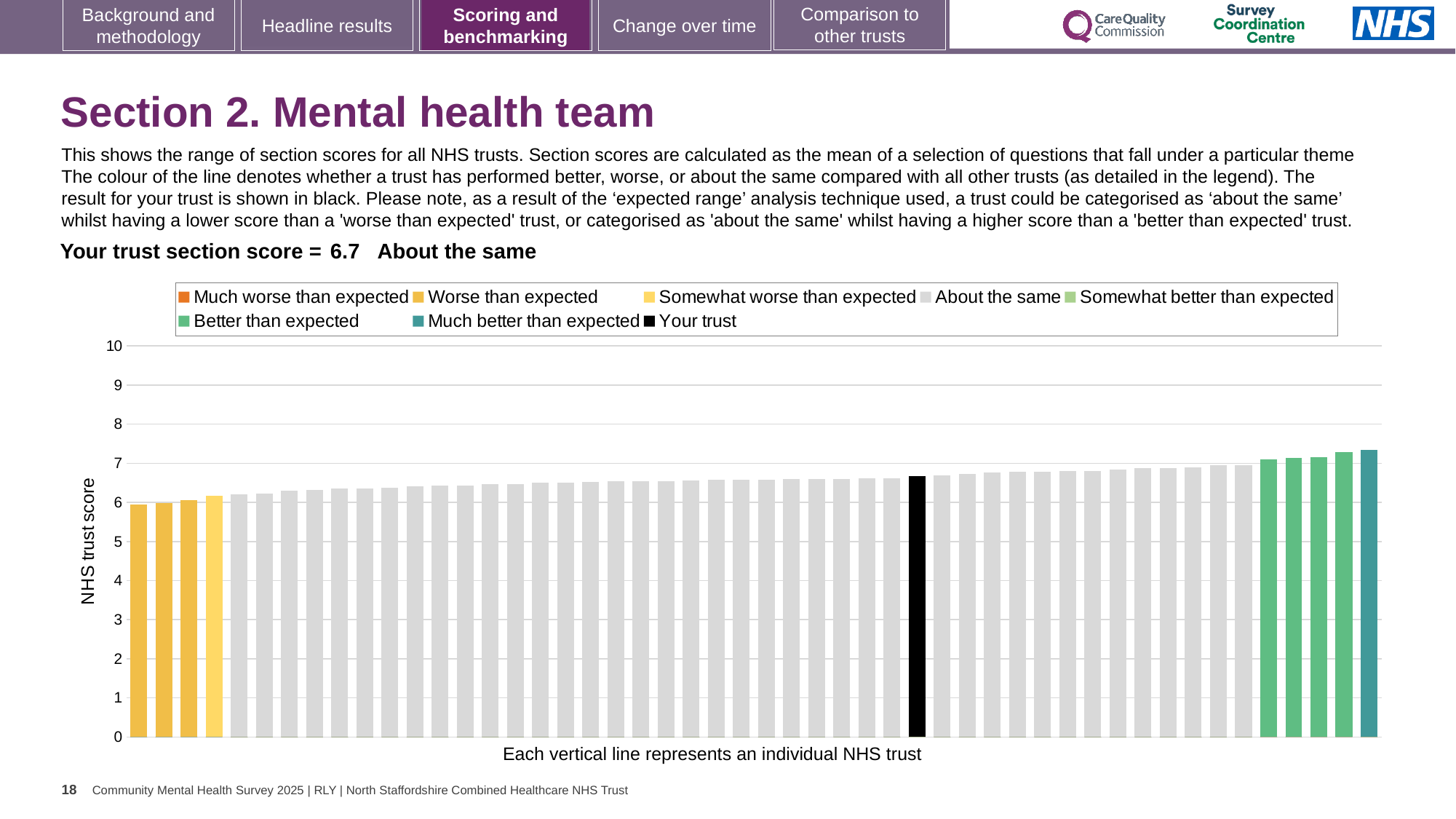
What does each vertical line in the chart represent, according to the x-axis label? an individual NHS trust What kind of chart is shown on the slide? bar chart How many entries does the chart legend list? 8 Is the value for your trust (the black bar) greater or less than 7? less Is the value of the leftmost bar greater or less than 7? less Which bar is higher: the leftmost bar or the rightmost bar? the rightmost bar Is the value of the rightmost bar greater or less than 7? greater Which performance category is your trust placed in for this section? About the same What is the section score for your trust, as printed on the slide? 6.7 Do the bar values rise or fall from left to right along the x axis? rise What is the label on the vertical axis of the chart? NHS trust score